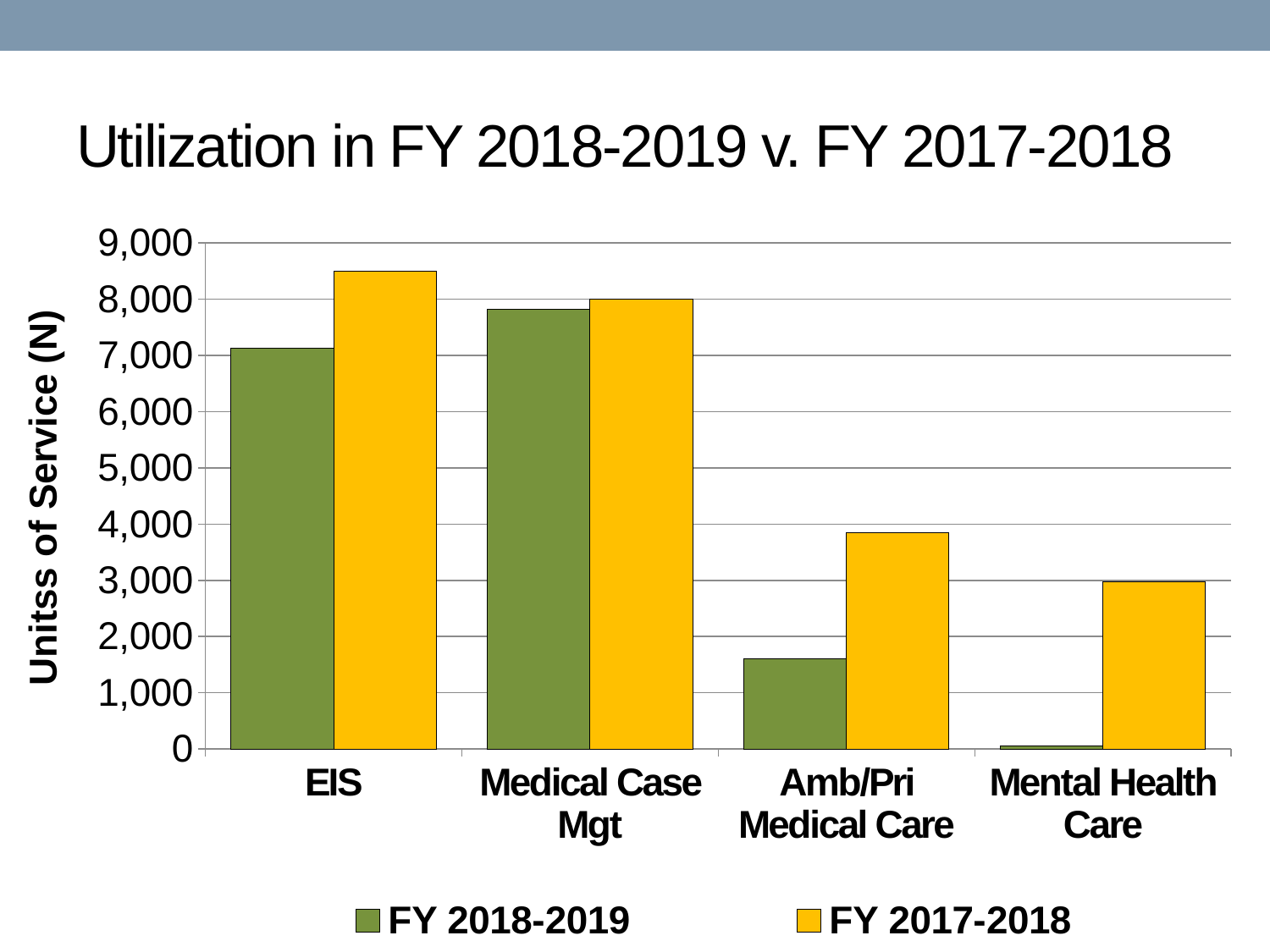
Which category has the lowest FY 2018-2019 value? Mental Health Care How many categories are shown on the x axis? 4 Is the FY 2017-2018 value for Mental Health Care greater or less than 2,000? greater What is the label of the y axis? Unitss of Service (N) Which category has the highest FY 2017-2018 value? EIS What kind of chart is shown on the slide? bar chart Which category has the highest FY 2018-2019 value? Medical Case Mgt Is the FY 2018-2019 value for Amb/Pri Medical Care greater or less than 2,000? less For EIS, which is larger: the FY 2018-2019 value or the FY 2017-2018 value? FY 2017-2018 Which category has the lowest FY 2017-2018 value? Mental Health Care Is the FY 2017-2018 value for EIS greater or less than 8,000? greater How many series does the legend list? 2